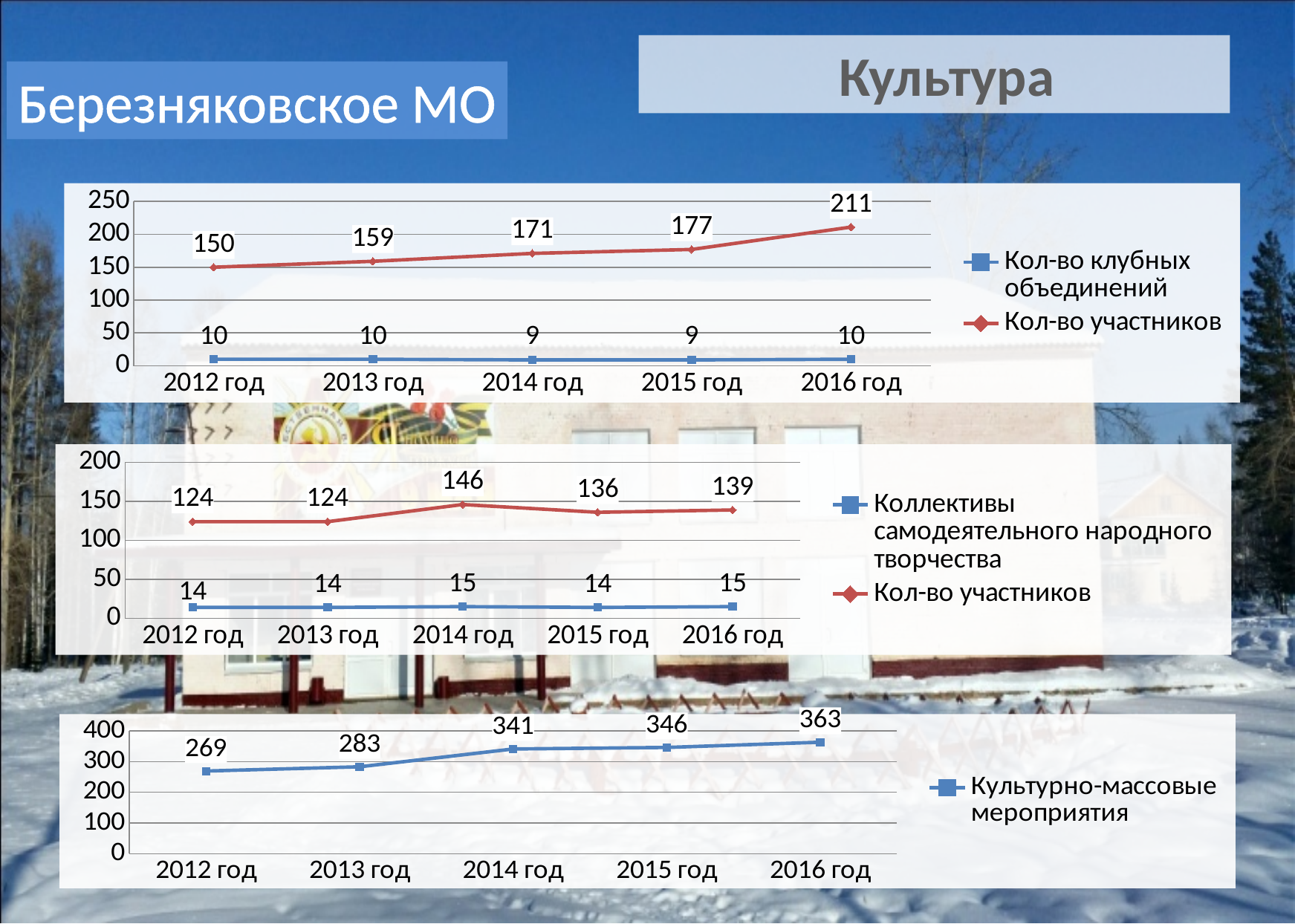
In the middle chart, which year has the highest value for Кол-во участников? 2014 год In the bottom chart, which year has the lowest value for Культурно-массовые мероприятия? 2012 год In the top chart, what is the value of Кол-во участников for 2016 год? 211 In the middle chart, what is the value of Коллективы самодеятельного народного творчества for 2015 год? 14 In the top chart, does Кол-во участников rise or fall from 2012 год to 2016 год? rise In the top chart, by how much did Кол-во участников increase from 2012 год to 2016 год? 61 In the top chart, what is the value of Кол-во клубных объединений for 2014 год? 9 In the bottom chart, what is the value of Культурно-массовые мероприятия for 2013 год? 283 What type of chart is the bottom chart? line chart How many years are shown on the x axis of the bottom chart? 5 In the middle chart, what is the difference between Кол-во участников in 2014 год and 2015 год? 10 In the top chart, how many series does the legend list? 2